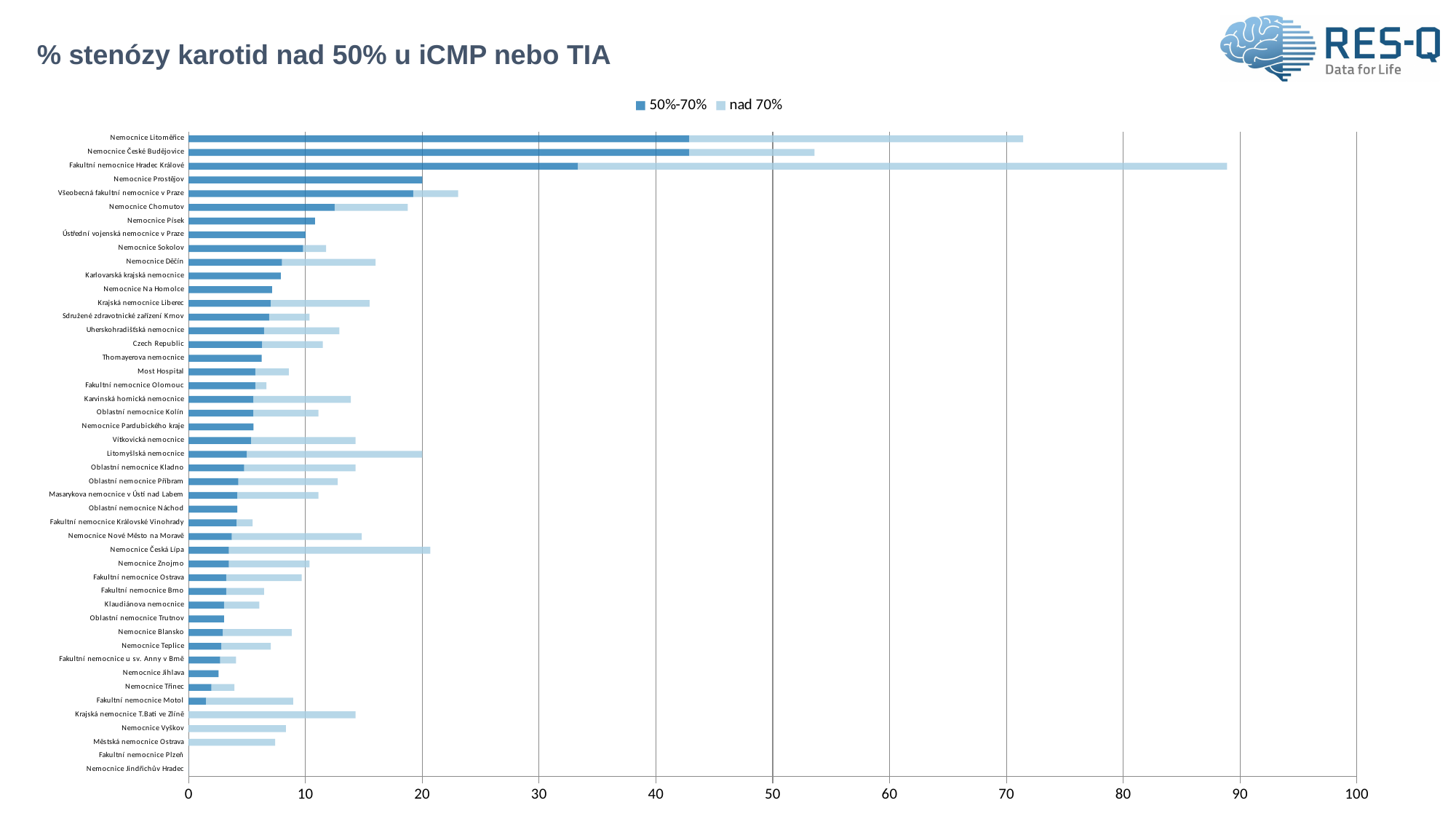
Which hospital has the longest total bar? Fakultní nemocnice Hradec Králové Is the total bar for Nemocnice Litoměřice greater or less than 60? greater Which has the longer 50%-70% bar, Fakultní nemocnice Hradec Králové or Nemocnice Prostějov? Fakultní nemocnice Hradec Králové Is the total bar for Nemocnice Chomutov greater or less than 20? less What is the title of the chart? % stenózy karotid nad 50% u iCMP nebo TIA Which has the longer total bar, Nemocnice Litoměřice or Nemocnice České Budějovice? Nemocnice Litoměřice What kind of chart is shown on the slide? bar chart How many series does the legend list? 2 Is the total bar for Fakultní nemocnice Hradec Králové greater or less than 80? greater What are the two series named in the legend? 50%-70% and nad 70%